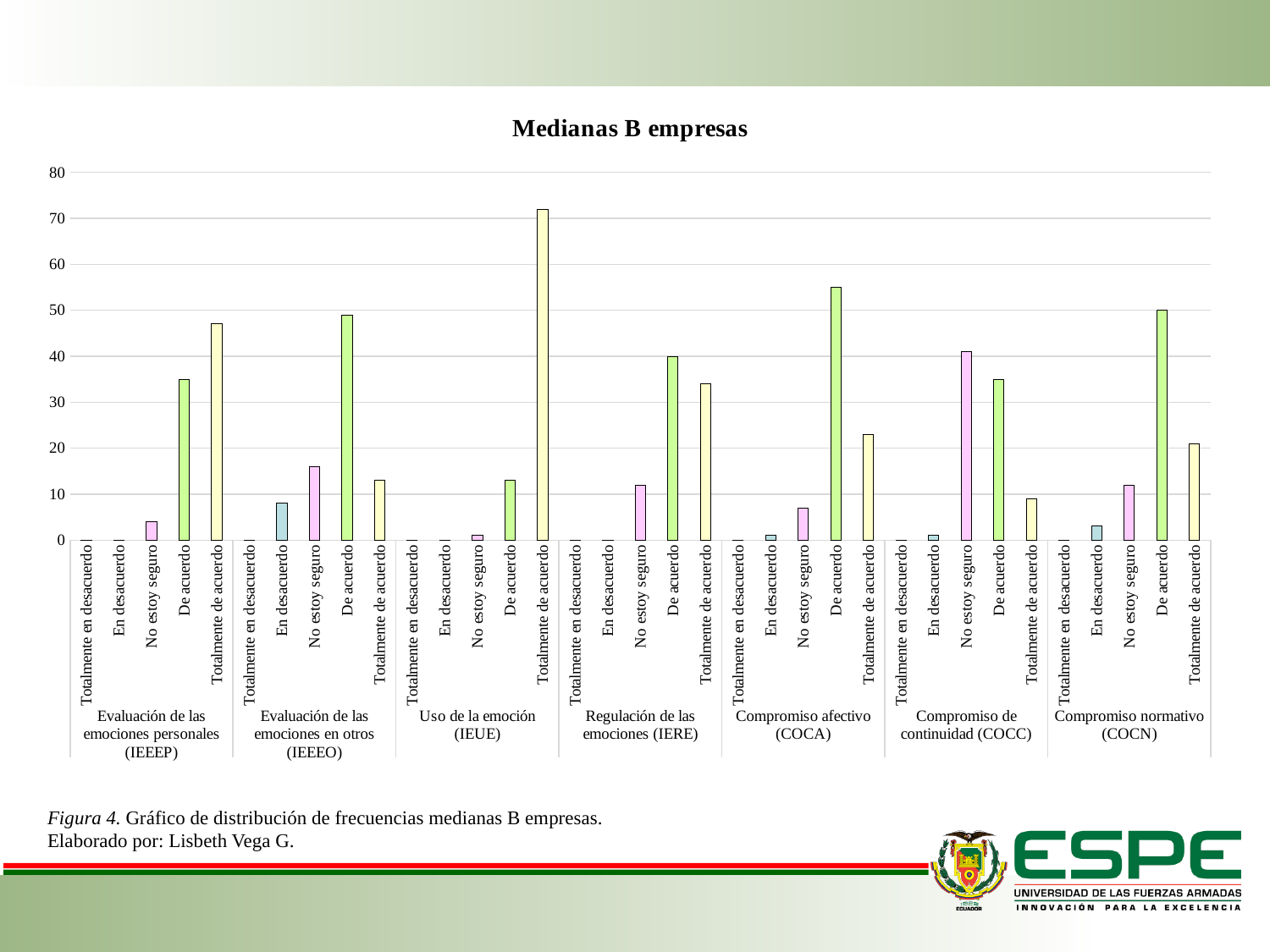
Which bar is the tallest in the whole chart? Totalmente de acuerdo in Uso de la emoción (IEUE) Is the value for De acuerdo in Compromiso afectivo (COCA) greater or less than 50? greater How many dimension groups (such as IEEEP, IEEEO, IEUE) are shown along the x axis? 7 Within Compromiso de continuidad (COCC), which response option has the highest value? No estoy seguro What is the title of the chart? Medianas B empresas Within Regulación de las emociones (IERE), which is larger: De acuerdo or Totalmente de acuerdo? De acuerdo Is the value for De acuerdo in Evaluación de las emociones personales (IEEEP) greater or less than 40? less Within Evaluación de las emociones personales (IEEEP), which is larger: De acuerdo or Totalmente de acuerdo? Totalmente de acuerdo Is the value for Totalmente de acuerdo in Uso de la emoción (IEUE) greater or less than 60? greater How many response options are shown within each dimension group? 5 What kind of chart is shown on the slide? bar chart